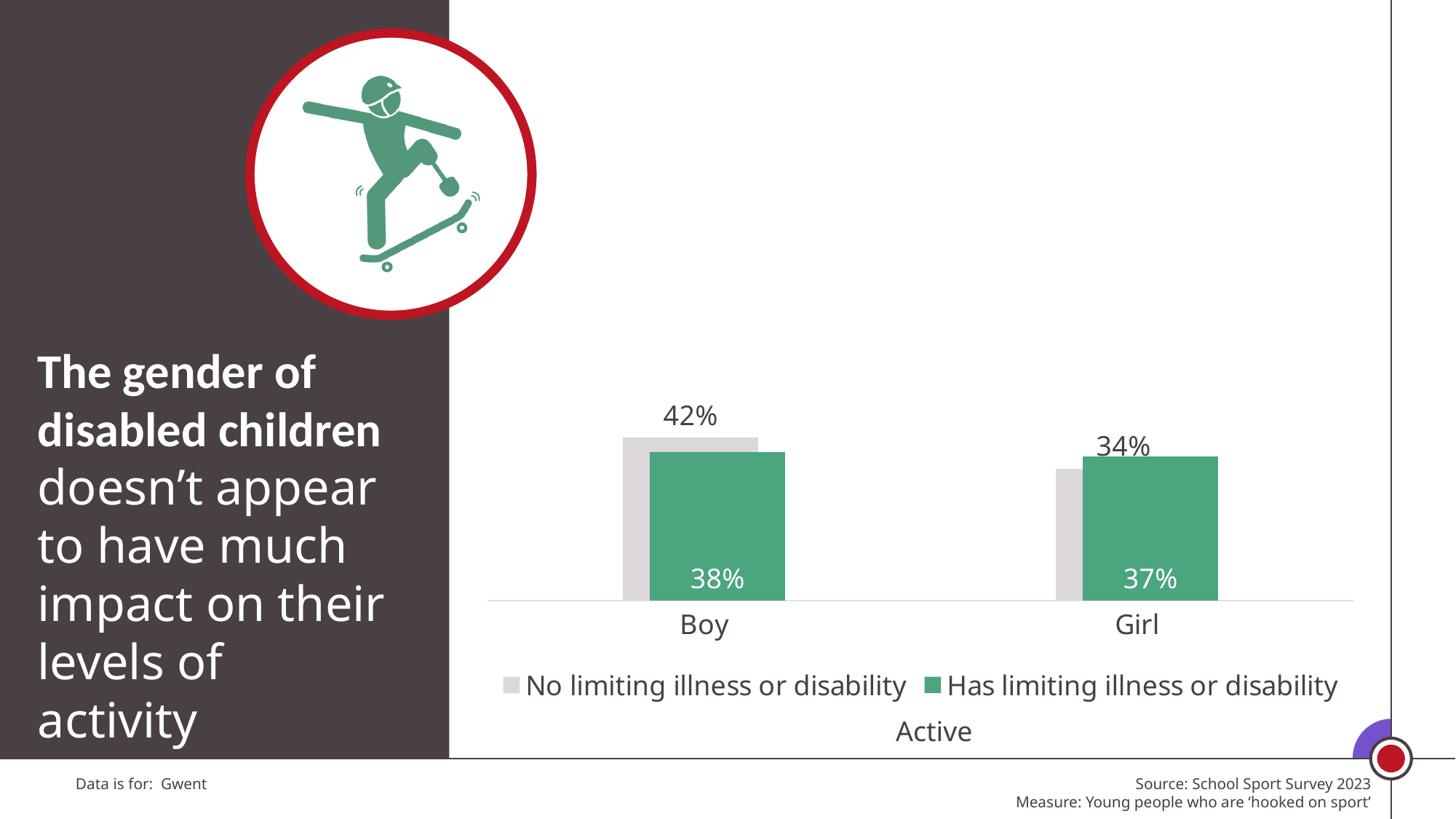
Which category has the highest value for the 'No limiting illness or disability' series? Boy How many categories are shown on the x axis? 2 How many series does the legend list? 2 What is the value for girls who have a limiting illness or disability? 37% What kind of chart is shown on the slide? bar chart What is the value for boys with no limiting illness or disability? 42% Which category has the lowest value for the 'Has limiting illness or disability' series? Girl For girls, which is larger: the value for 'No limiting illness or disability' or 'Has limiting illness or disability'? Has limiting illness or disability What is the value for boys who have a limiting illness or disability? 38% What is the value for girls with no limiting illness or disability? 34% What is the difference between the 'No limiting illness or disability' values for boys and girls? 8%